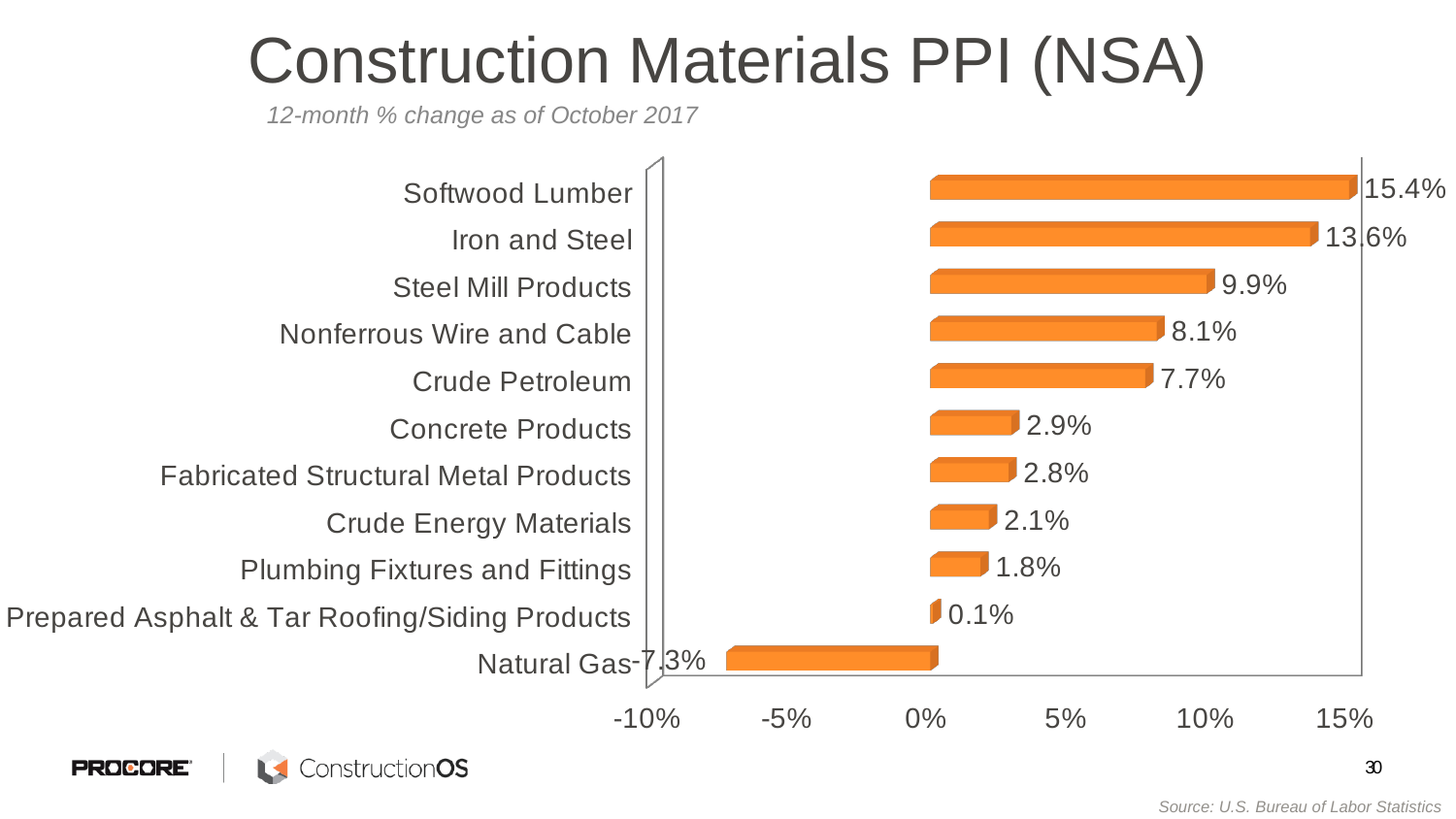
What is the value shown for Natural Gas? -7.3% Which category has the highest 12-month % change? Softwood Lumber What is the value shown for Crude Petroleum? 7.7% What is the 12-month % change for Softwood Lumber? 15.4% What is the title of the chart? Construction Materials PPI (NSA) Which category has the lowest 12-month % change? Natural Gas How many categories are shown in the chart? 11 Is the value for Iron and Steel greater or less than 10%? greater What is the value shown for Plumbing Fixtures and Fittings? 1.8% What is the difference between the values for Softwood Lumber and Iron and Steel? 1.8% What kind of chart is shown on the slide? Bar chart Which is larger, the value for Steel Mill Products or the value for Nonferrous Wire and Cable? Steel Mill Products